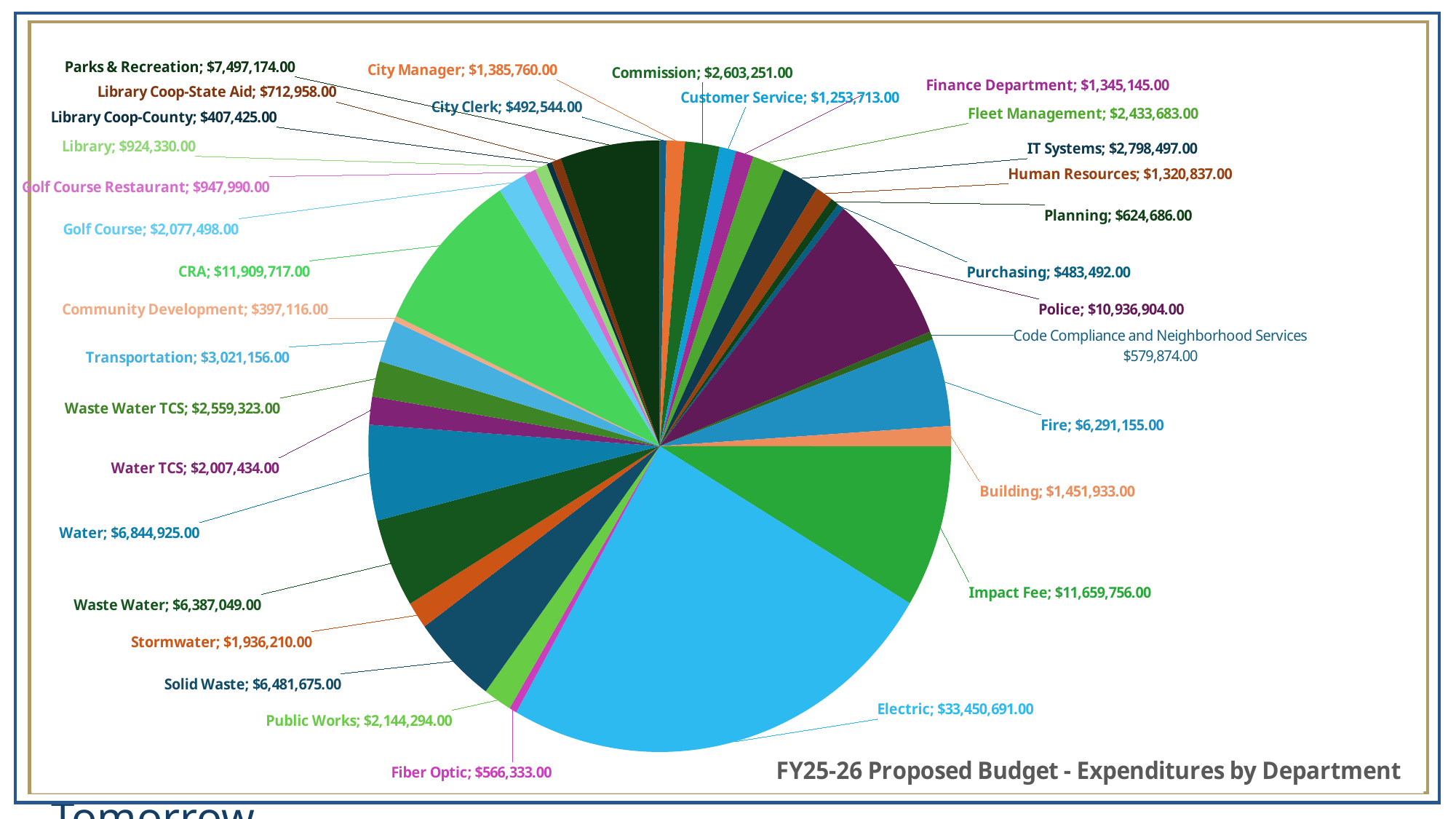
What is the value for Code Compliance and Neighborhood Services? $579,874.00 What is the value for Police? $10,936,904.00 What is the title of the chart? FY25-26 Proposed Budget - Expenditures by Department What is the difference between the Electric and Impact Fee values? $21,790,935.00 Which is larger, Water or Fire? Water What is the difference between the CRA and Police values? $972,813.00 Which department has the largest expenditure? Electric How many departments are shown in the pie chart? 33 What is the value for Electric? $33,450,691.00 What is the value for Waste Water TCS? $2,559,323.00 What type of chart is shown on the slide? Pie chart Which department has the smallest expenditure? Community Development